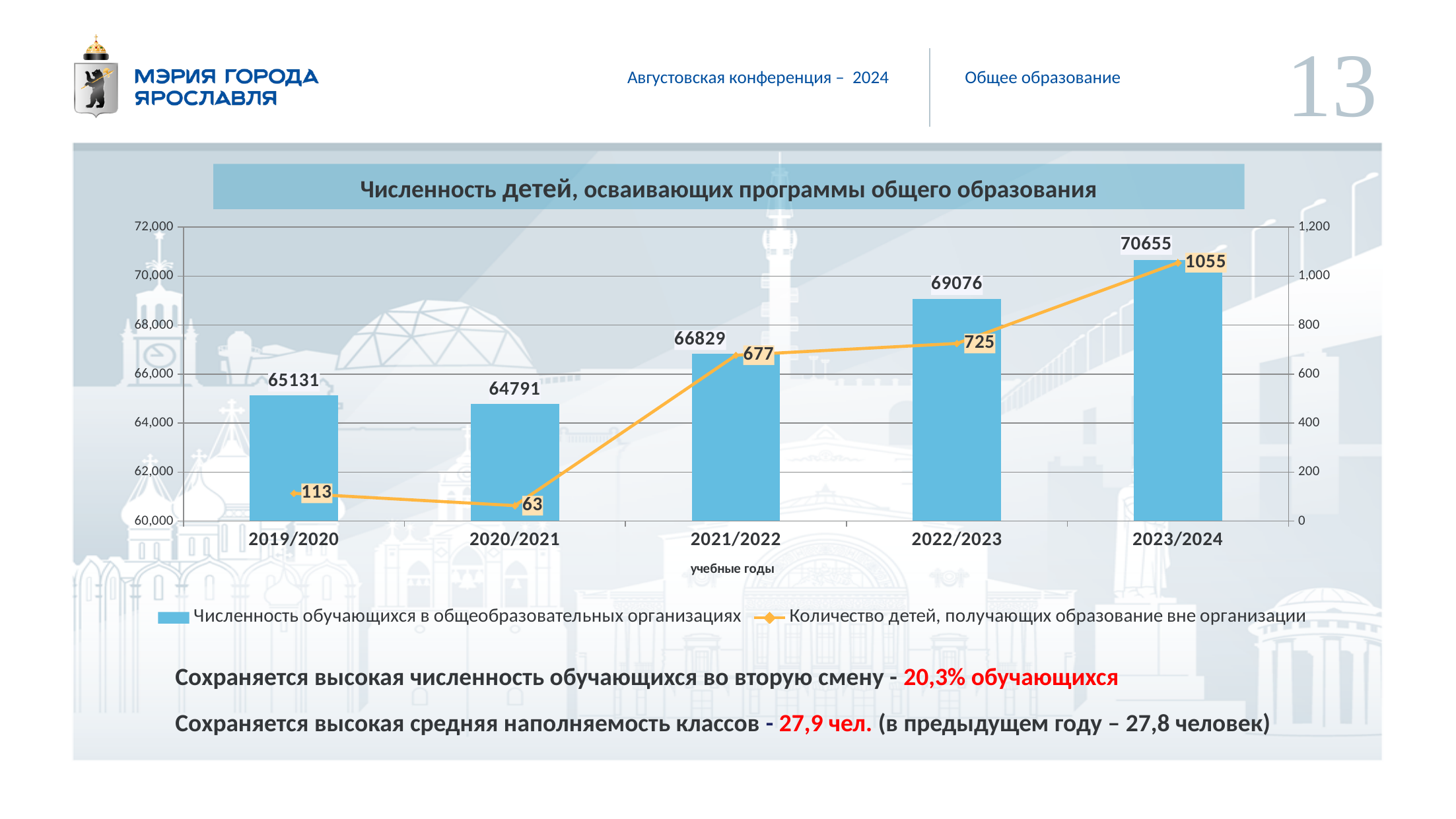
Which school year has the lowest number of children receiving education outside an organization? 2020/2021 Which is larger: the number of students in general education organizations in 2019/2020 or in 2020/2021? 2019/2020 How many school years are shown on the x axis of the chart? 5 From 2020/2021 to 2023/2024, does the number of children receiving education outside an organization rise or fall? rise How many children received education outside an organization (Количество детей, получающих образование вне организации) in 2020/2021? 63 How many series does the chart legend list? 2 Is the number of children receiving education outside an organization in 2023/2024 greater or less than 1,000? greater What kind of chart is used to show the number of students in general education organizations? bar chart What is the difference between the number of students in general education organizations in 2023/2024 and in 2022/2023? 1579 Which school year has the highest number of students in general education organizations? 2023/2024 What is the number of students in general education organizations (Численность обучающихся в общеобразовательных организациях) for 2021/2022? 66829 What is the title of the chart? Численность детей, осваивающих программы общего образования